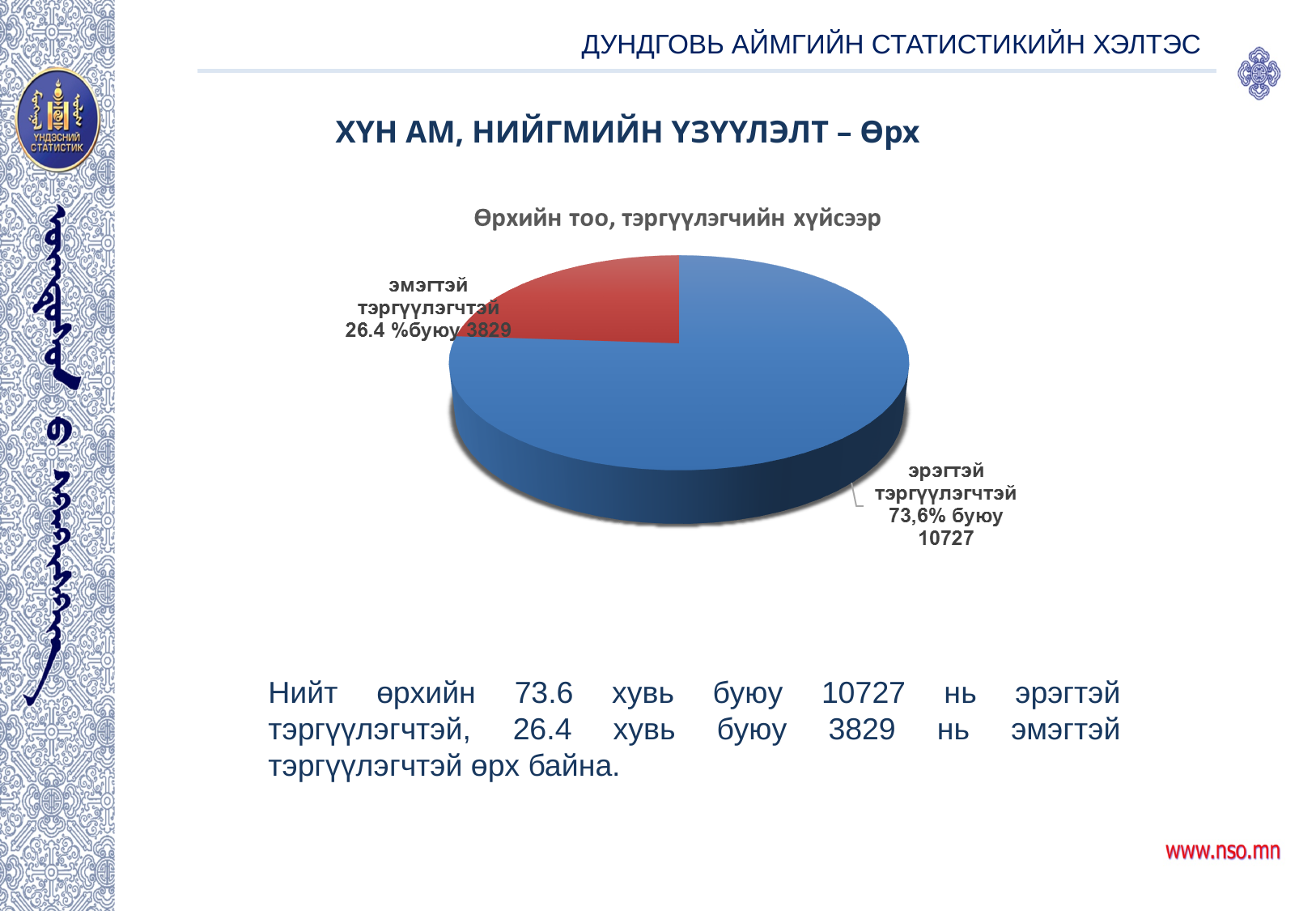
How many slices does the pie chart have? 2 What type of chart is shown on the slide? pie chart What is the difference between the number of male-headed and female-headed households? 6898 What is the title of the chart? Өрхийн тоо, тэргүүлэгчийн хүйсээр What share of the pie is the эмэгтэй тэргүүлэгчтэй slice? 26.4 % How many households are headed by men (эрэгтэй тэргүүлэгчтэй) according to the chart? 10727 Which slice of the pie is the largest? эрэгтэй тэргүүлэгчтэй How many households are headed by women (эмэгтэй тэргүүлэгчтэй) according to the chart? 3829 What share of the pie is the эрэгтэй тэргүүлэгчтэй slice? 73,6% What colour is the эмэгтэй тэргүүлэгчтэй slice? red Which slice of the pie is the smallest? эмэгтэй тэргүүлэгчтэй What is the total number of households shown in the pie chart? 14556